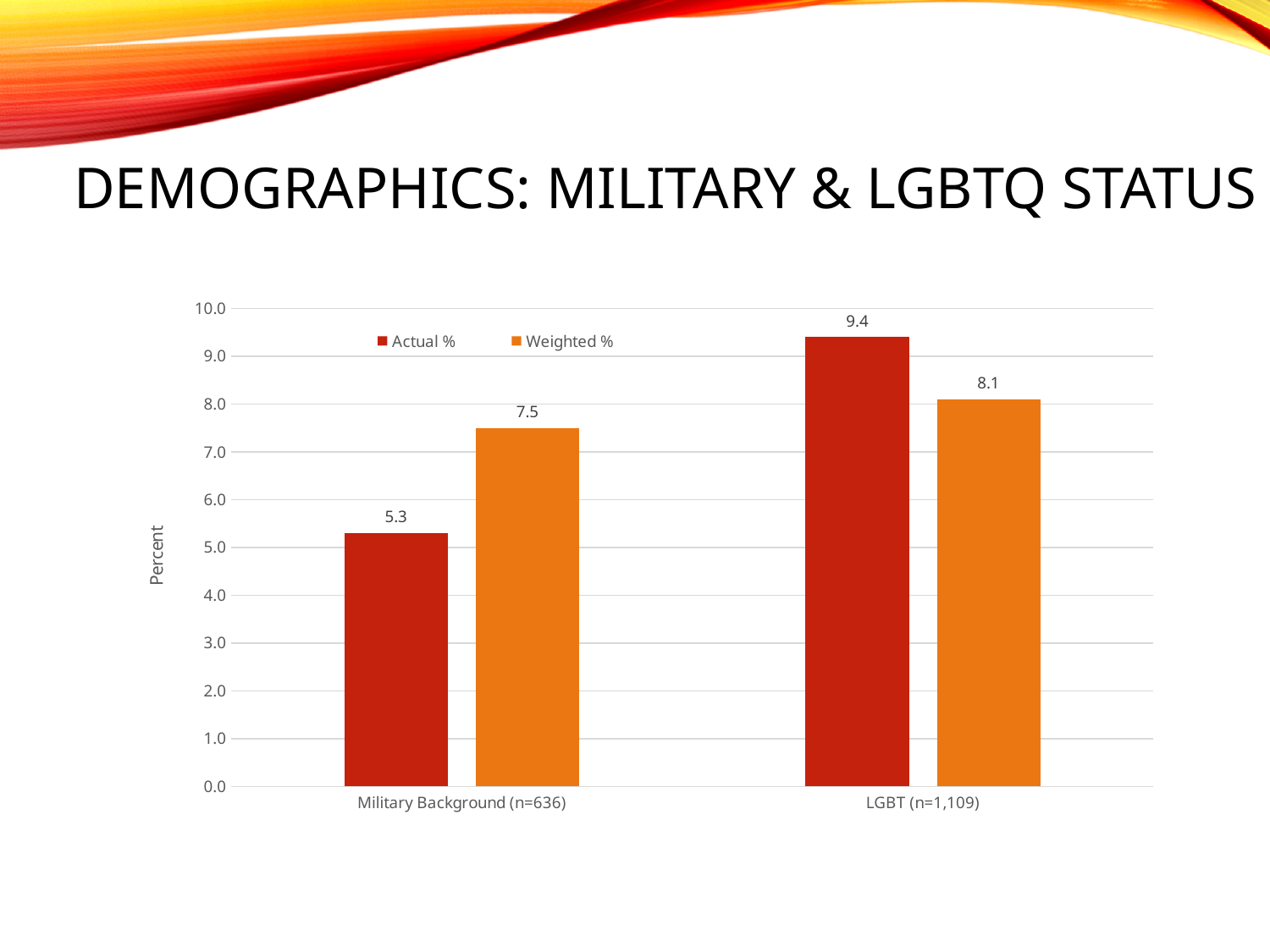
Which category has the highest Actual % value? LGBT (n=1,109) What kind of chart is shown on the slide? Bar chart What is the Actual % value for Military Background (n=636)? 5.3 Is the Actual % value for LGBT (n=1,109) greater or less than 9.0? greater What is the Weighted % value for Military Background (n=636)? 7.5 How many categories are shown on the x axis? 2 How many series does the legend list? 2 Which category has the lowest Weighted % value? Military Background (n=636) What is the label of the vertical axis? Percent For Military Background (n=636), which is larger: Actual % or Weighted %? Weighted % What is the Weighted % value for LGBT (n=1,109)? 8.1 What is the difference between the Actual % and Weighted % values for LGBT (n=1,109)? 1.3